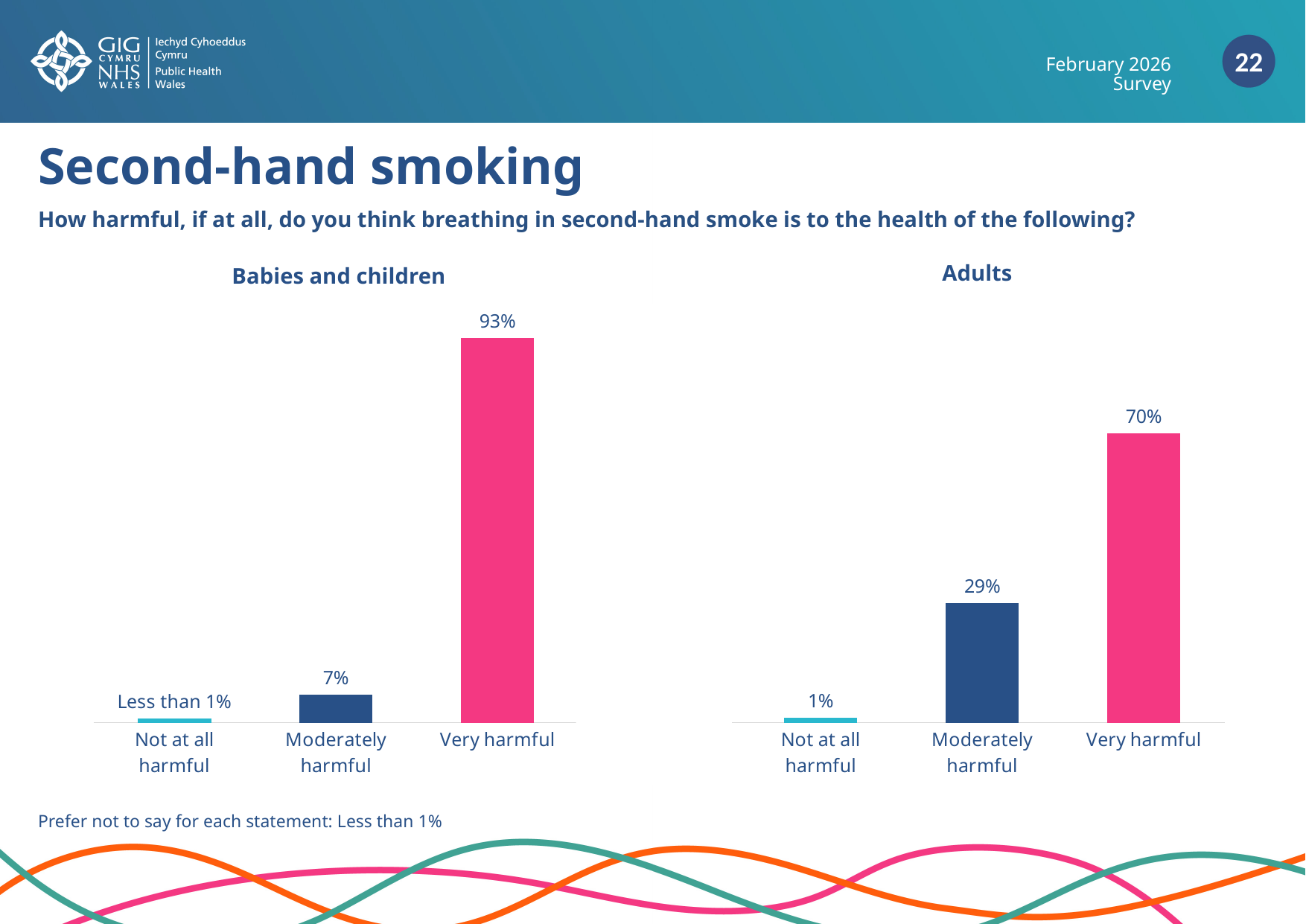
What kind of chart is the 'Babies and children' chart? Bar chart Which is larger: 'Very harmful' in the 'Babies and children' chart or 'Very harmful' in the 'Adults' chart? Babies and children In the 'Adults' chart, what is the value for 'Not at all harmful'? 1% In the 'Babies and children' chart, what is the value for 'Very harmful'? 93% In the 'Babies and children' chart, which category has the lowest value? Not at all harmful In the 'Babies and children' chart, what is the value shown for 'Not at all harmful'? Less than 1% How many categories are shown in the 'Adults' chart? 3 In the 'Adults' chart, what is the difference between the values for 'Very harmful' and 'Moderately harmful'? 41% In the 'Adults' chart, what is the value for 'Moderately harmful'? 29% In the 'Adults' chart, what is the value for 'Very harmful'? 70% In the 'Babies and children' chart, what is the value for 'Moderately harmful'? 7% In the 'Adults' chart, which category has the highest value? Very harmful